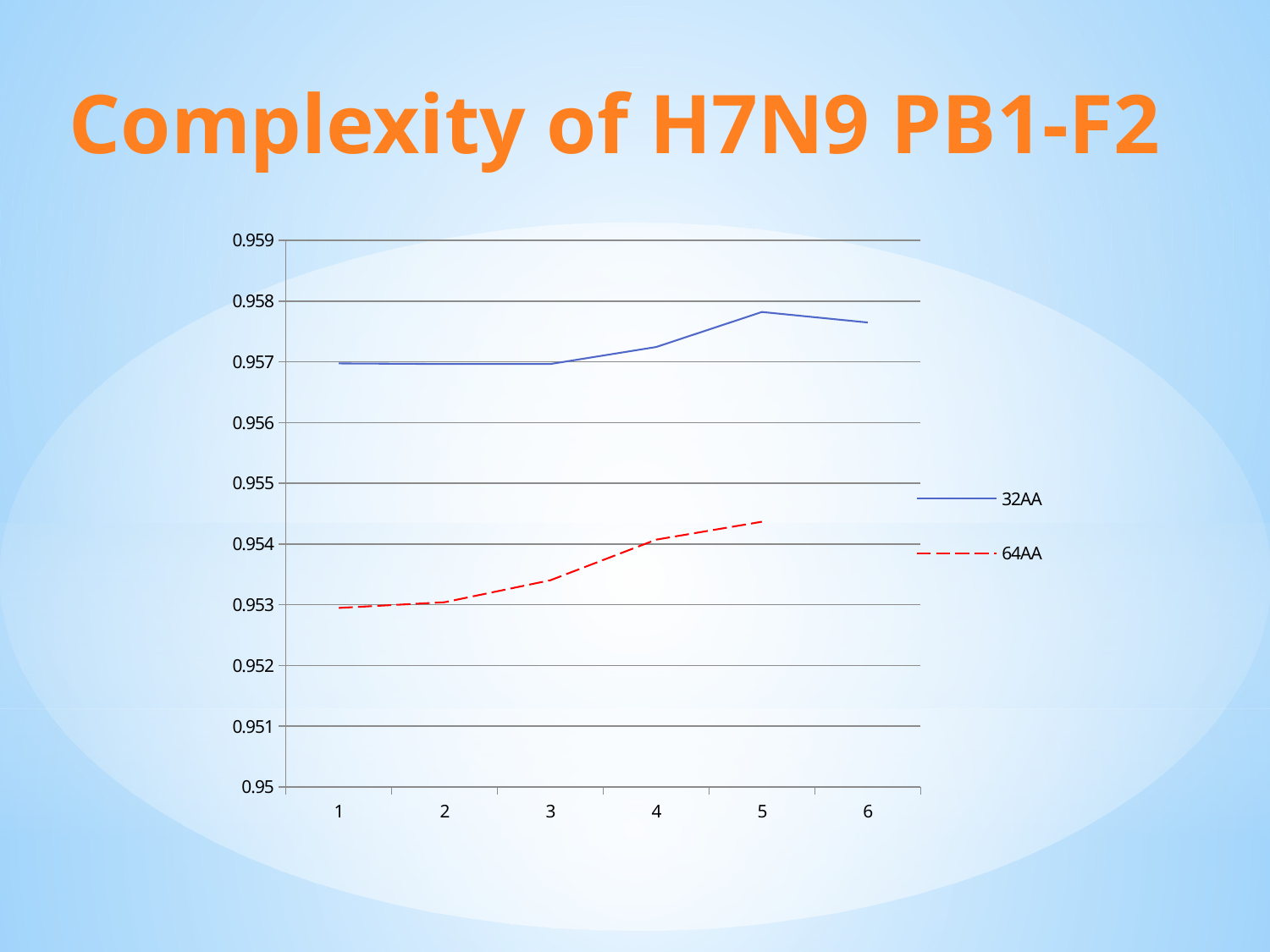
Which series has the higher value at x = 3, 32AA or 64AA? 32AA Is the value for 32AA at x = 5 greater or less than 0.957? greater What is the title of the chart? Complexity of H7N9 PB1-F2 Is the value for 64AA at x = 1 greater or less than 0.954? less What kind of chart is shown on the slide? line chart At which x value does the 32AA series reach its highest point? 5 Is the value for 32AA at x = 1 greater or less than 0.958? less Does the 64AA series rise or fall from x = 1 to x = 5? rise Which series is drawn with a dashed red line? 64AA How many categories are shown on the x axis? 6 How many series does the legend list? 2